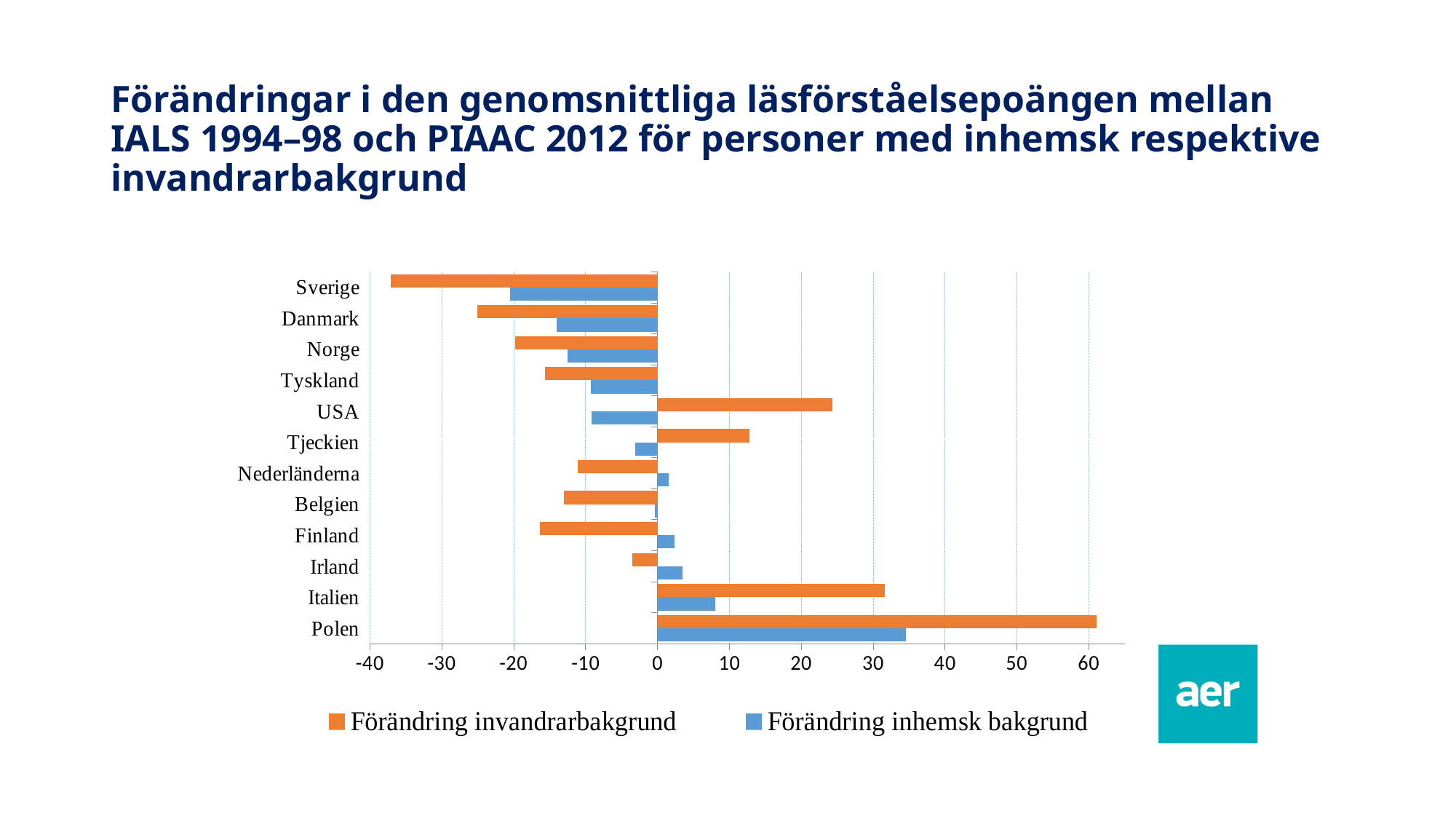
How many series does the legend list? 2 Is the Förändring invandrarbakgrund value for Polen greater or less than 50? greater Which country has the lowest value for Förändring inhemsk bakgrund? Sverige Is the Förändring invandrarbakgrund value for Sverige greater or less than -30? less What kind of chart is shown on the slide? Bar chart Which colour represents Förändring invandrarbakgrund in the legend? Orange Which country has the lowest value for Förändring invandrarbakgrund? Sverige Which country has the highest value for Förändring invandrarbakgrund? Polen How many countries are listed on the chart? 12 Which has the larger Förändring invandrarbakgrund value, Italien or USA? Italien Which country has the highest value for Förändring inhemsk bakgrund? Polen Is the Förändring invandrarbakgrund value for USA greater or less than 20? greater